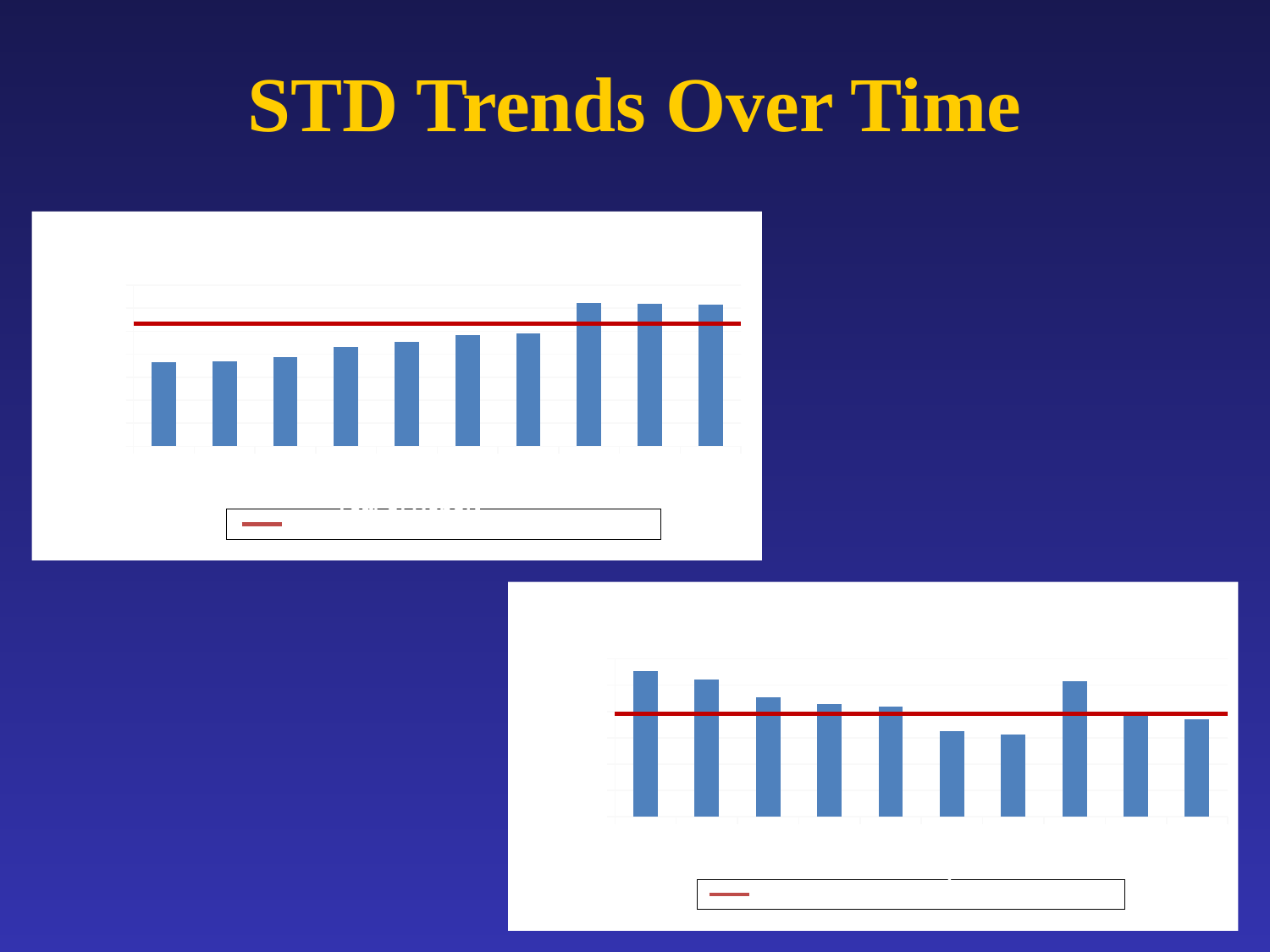
In the bottom-right chart, which is taller, the second bar or the sixth bar? the second bar How many bars are plotted in the bottom-right chart? 10 How many charts are shown on the slide? 2 In the top-left chart, which bar is the shortest? the leftmost (first) bar How many bars are plotted in the top-left chart? 10 What kind of chart is the top-left chart? bar chart In the top-left chart, which is taller, the first bar or the last bar? the last bar What colour is the horizontal line drawn across the bars in each chart? red In the bottom-right chart, which bar is the tallest? the leftmost (first) bar What kind of chart is the bottom-right chart? bar chart In the top-left chart, do the bars rise or fall from left to right? rise In the bottom-right chart, which is taller, the first bar or the seventh bar? the first bar